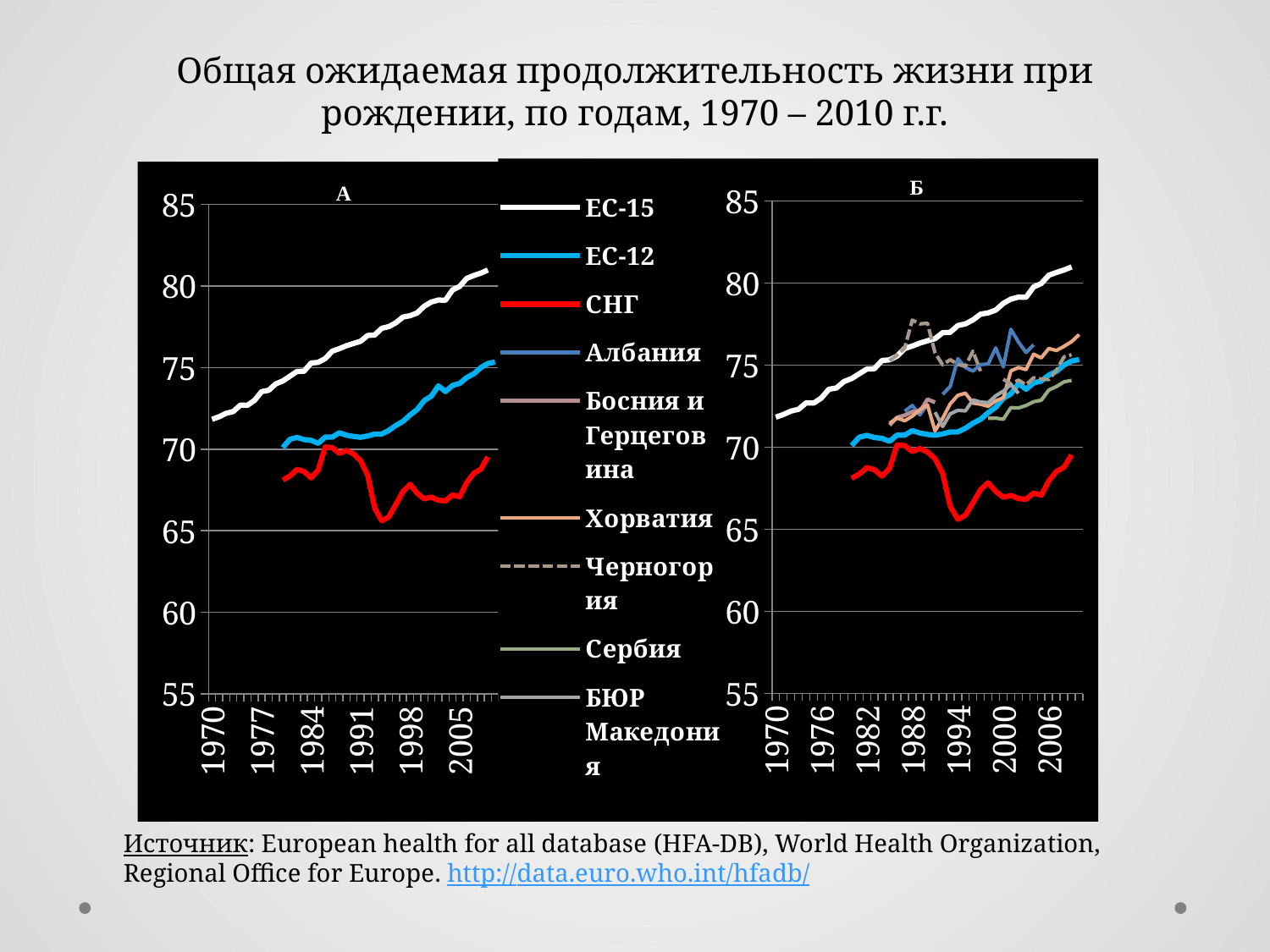
In chart B, is the value for Сербия in 2010 greater or less than 75? less In chart A, is the value for ЕС-15 in 1970 greater or less than 75? less What is the title of the slide's charts? Общая ожидаемая продолжительность жизни при рождении, по годам, 1970 – 2010 г.г. In chart A, does the ЕС-15 line rise or fall from 1970 to 2010? rises In chart A, is the value for СНГ around 1995 greater or less than 70? less What kind of chart is chart A on the slide? line chart How many lines are plotted in chart A? 3 How many series does the shared legend list? 9 In chart B, which series is drawn with a dashed line? Черногория In chart A, which is larger in 2010: ЕС-15 or СНГ? ЕС-15